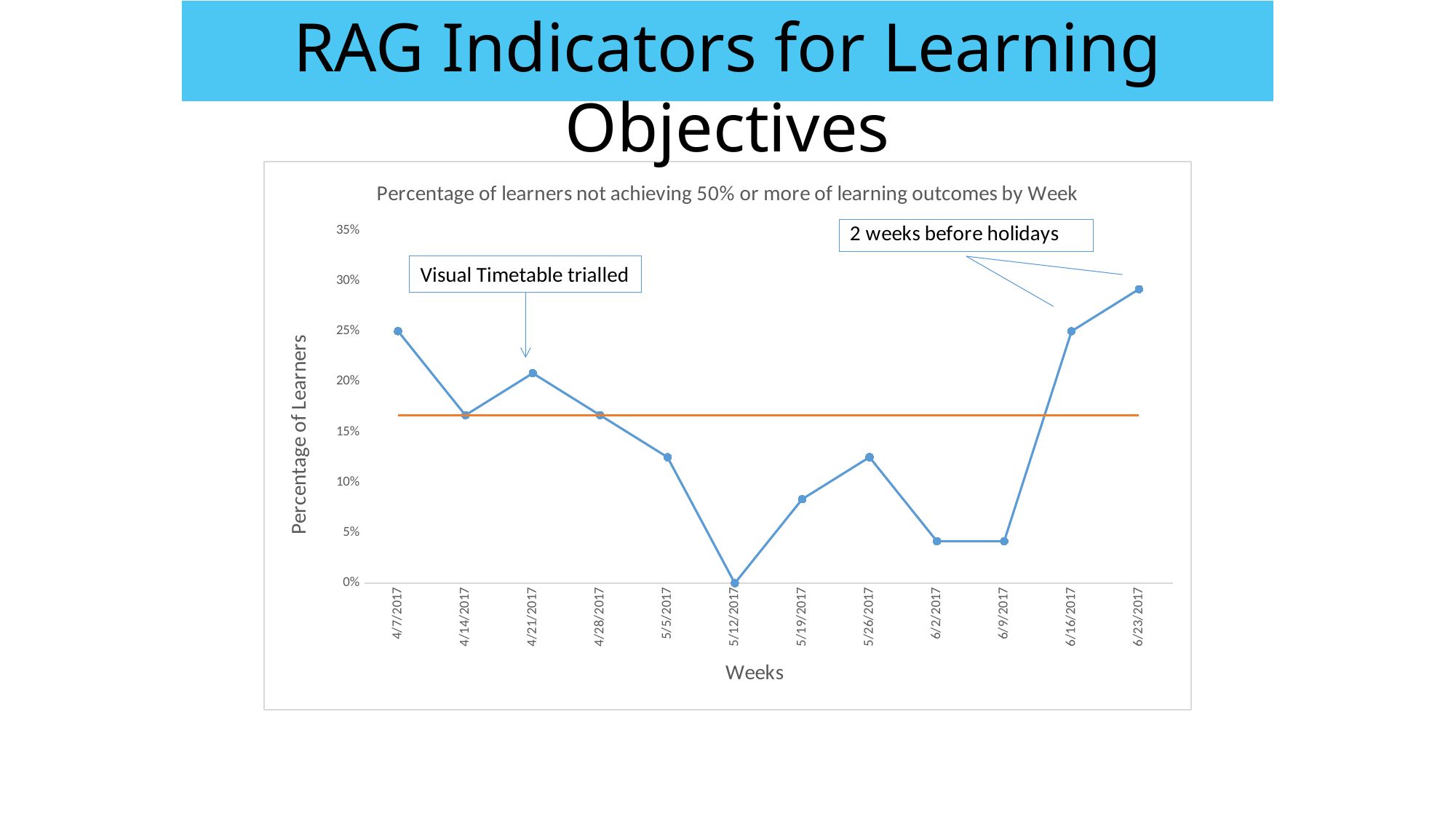
How many weekly data points are plotted on the chart? 12 Is the value for 4/21/2017 greater or less than 20%? greater Is the value for 6/2/2017 greater or less than 5%? less Is the value for 6/23/2017 greater or less than 30%? less Which week has the highest percentage of learners? 6/23/2017 Do the values rise or fall from 6/9/2017 to 6/23/2017? rise Which is larger, the value for 5/19/2017 or the value for 5/26/2017? 5/26/2017 What is the title of the chart? Percentage of learners not achieving 50% or more of learning outcomes by Week What is the value for 5/12/2017? 0% What type of chart is shown on the slide? line chart What is the value for 4/7/2017? 25% Which week has the lowest percentage of learners? 5/12/2017